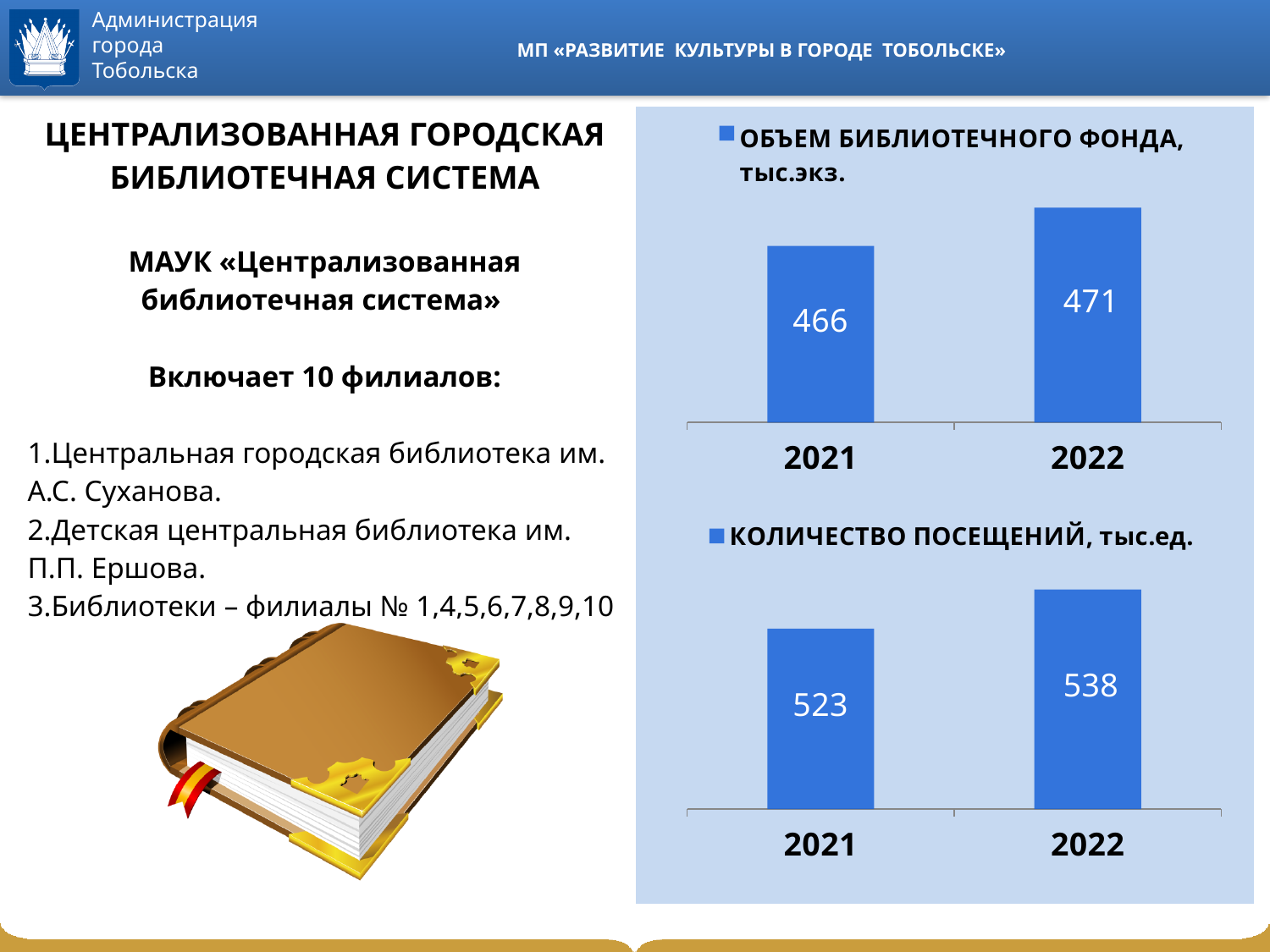
In the chart titled «ОБЪЕМ БИБЛИОТЕЧНОГО ФОНДА, тыс.экз.», do the values rise or fall from 2021 to 2022? rise In the chart titled «КОЛИЧЕСТВО ПОСЕЩЕНИЙ, тыс.ед.», what is the value for 2022? 538 What type of chart is the chart titled «КОЛИЧЕСТВО ПОСЕЩЕНИЙ, тыс.ед.»? bar chart In the chart titled «ОБЪЕМ БИБЛИОТЕЧНОГО ФОНДА, тыс.экз.», what is the value for 2022? 471 In the chart titled «КОЛИЧЕСТВО ПОСЕЩЕНИЙ, тыс.ед.», what is the difference between the 2022 and 2021 values? 15 In the chart titled «ОБЪЕМ БИБЛИОТЕЧНОГО ФОНДА, тыс.экз.», by how much does the 2022 value exceed the 2021 value? 5 In the chart titled «КОЛИЧЕСТВО ПОСЕЩЕНИЙ, тыс.ед.», which year has the lower value? 2021 In the chart titled «КОЛИЧЕСТВО ПОСЕЩЕНИЙ, тыс.ед.», is the value for 2022 larger or smaller than the value for 2021? larger How many categories (years) are shown in the chart titled «ОБЪЕМ БИБЛИОТЕЧНОГО ФОНДА, тыс.экз.»? 2 In the chart titled «ОБЪЕМ БИБЛИОТЕЧНОГО ФОНДА, тыс.экз.», which year has the higher value? 2022 In the chart titled «ОБЪЕМ БИБЛИОТЕЧНОГО ФОНДА, тыс.экз.», what is the value for 2021? 466 In the chart titled «КОЛИЧЕСТВО ПОСЕЩЕНИЙ, тыс.ед.», what is the value for 2021? 523